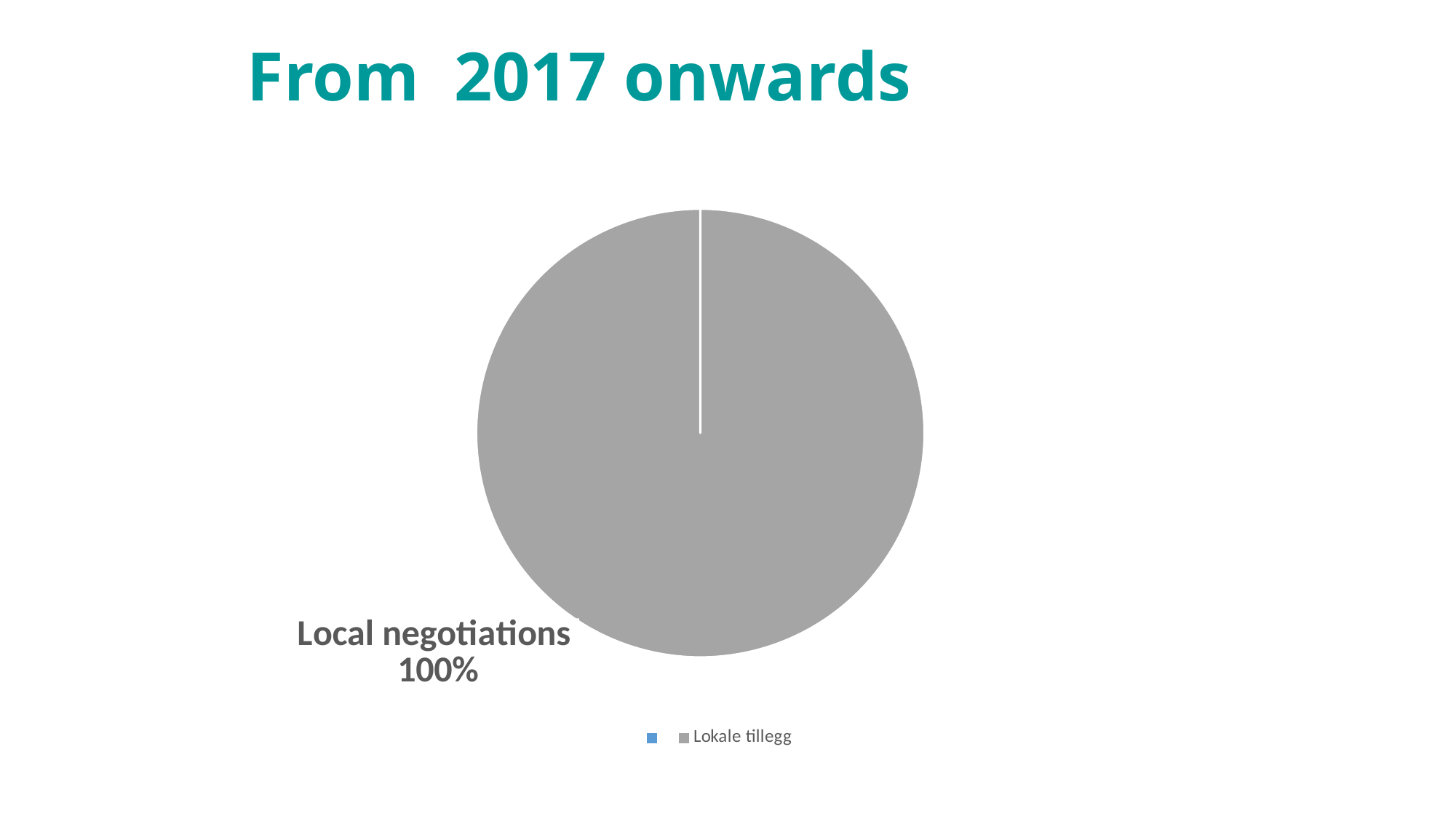
What value is printed for the Local negotiations slice? 100% What is the title of the slide containing the pie chart? From 2017 onwards Is the share for Local negotiations greater or less than 50%? greater What share of the pie does the Local negotiations slice take? 100% How many labelled slices are visible in the pie chart? 1 What legend label is shown next to the grey marker below the pie chart? Lokale tillegg What kind of chart is shown on the slide? pie chart